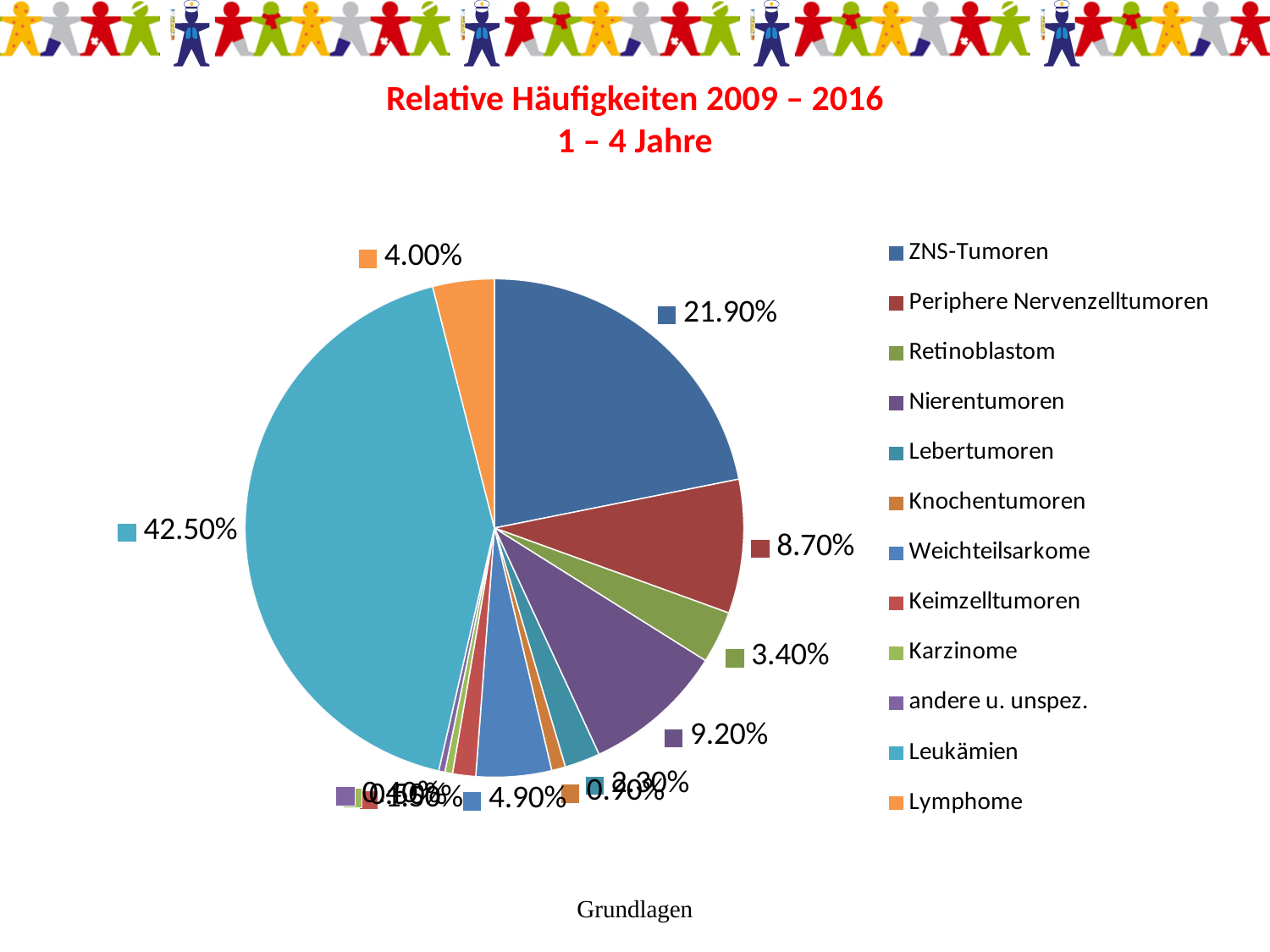
What share of the pie is Leukämien? 42.50% What is the value shown for Lymphome? 4.00% What is the difference between the Leukämien share and the ZNS-Tumoren share? 20.60% Which category has the largest slice of the pie? Leukämien How many categories does the legend list? 12 What is the value shown for Weichteilsarkome? 4.90% What is the value shown for Periphere Nervenzelltumoren? 8.70% What is the value shown for Nierentumoren? 9.20% Which is larger, the slice for ZNS-Tumoren or the slice for Nierentumoren? ZNS-Tumoren What is the value shown for Retinoblastom? 3.40% What kind of chart is shown on the slide? pie chart What is the value shown for ZNS-Tumoren? 21.90%